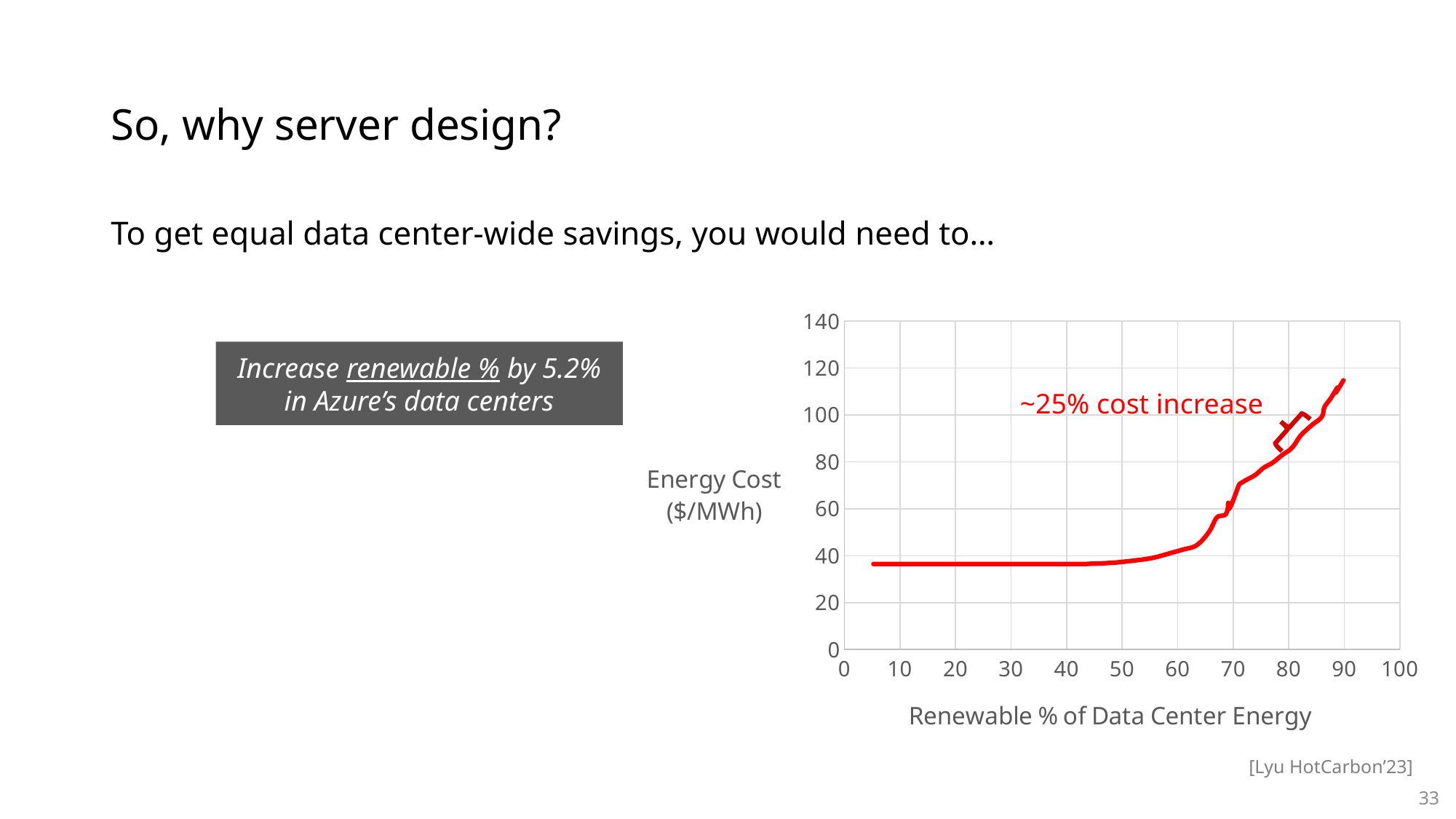
Is the energy cost at 70% renewable greater or less than 60 $/MWh? greater Which is larger, the energy cost at 30% renewable or at 80% renewable? 80% renewable What is the y-axis title of the chart? Energy Cost ($/MWh) What is the maximum value shown on the y-axis of the chart? 140 Does the energy cost rise or fall as the renewable % increases from 50 to 90? rise Is the energy cost at 60% renewable greater or less than 60 $/MWh? less Is the energy cost at 90% renewable greater or less than 100 $/MWh? greater What is the x-axis title of the chart? Renewable % of Data Center Energy What kind of chart is shown on the slide? line chart